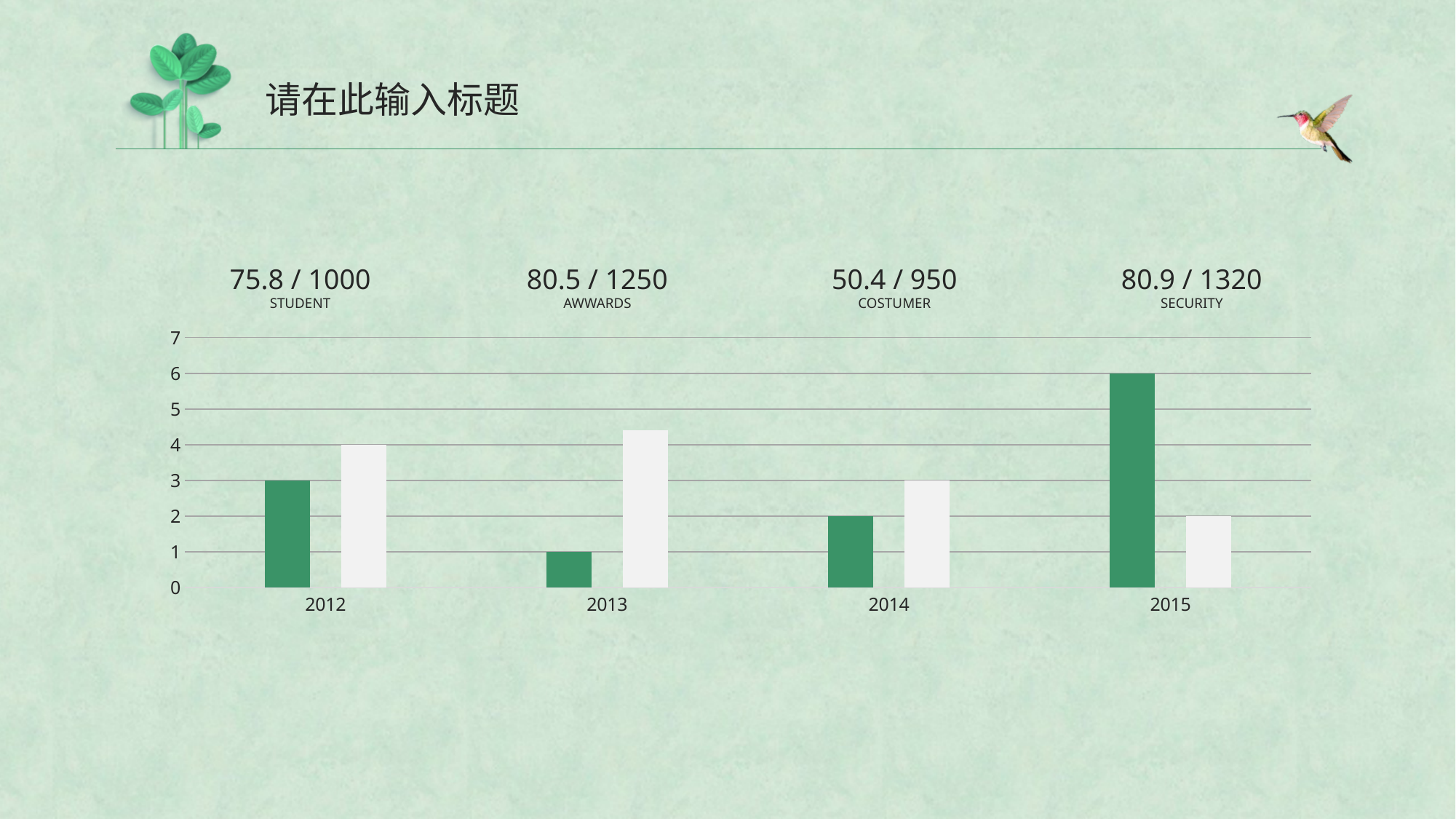
What is the difference between the green bar for 2015 and the green bar for 2012? 3 How many year categories are shown on the x axis of the chart? 4 What is the value of the green bar for 2015? 6 For 2015, which bar is taller, the green bar or the white bar? the green bar For 2012, which bar is taller, the green bar or the white bar? the white bar Is the value of the white bar for 2013 greater or less than 4? greater What is the value of the white bar for 2014? 3 What is the value of the green bar for 2012? 3 What kind of chart is shown on the slide? bar chart Which year has the highest green bar? 2015 Which year has the lowest green bar? 2013 What text label appears above the 2013 group of bars? 80.5 / 1250 AWWARDS